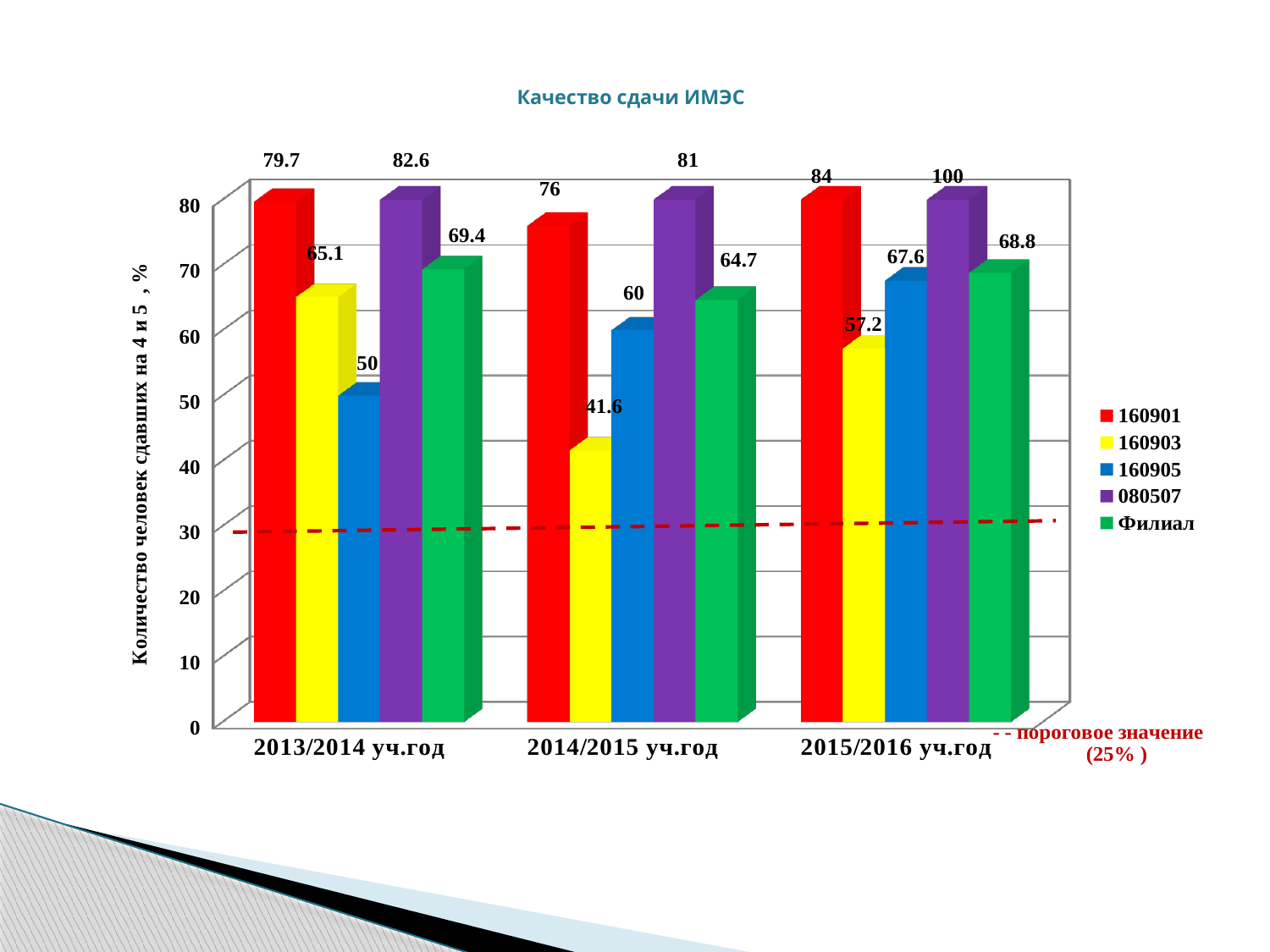
How many academic-year categories are shown on the x axis? 3 What is the value for Филиал in 2014/2015 уч.год? 64.7 Which series has the highest value in 2015/2016 уч.год? 080507 What kind of chart is shown on the slide? Bar chart What is the value for 080507 in 2015/2016 уч.год? 100 What is the difference between the 160901 values in 2015/2016 уч.год and 2014/2015 уч.год? 8 What is the value for 160901 in 2013/2014 уч.год? 79.7 Which series has the lowest value in 2013/2014 уч.год? 160905 Which is larger: the value for 160905 in 2015/2016 уч.год or the value for Филиал in 2015/2016 уч.год? Филиал How many series does the legend list? 5 Do the values for 160905 rise or fall across the academic years from 2013/2014 to 2015/2016? Rise What is the value for 160903 in 2014/2015 уч.год? 41.6